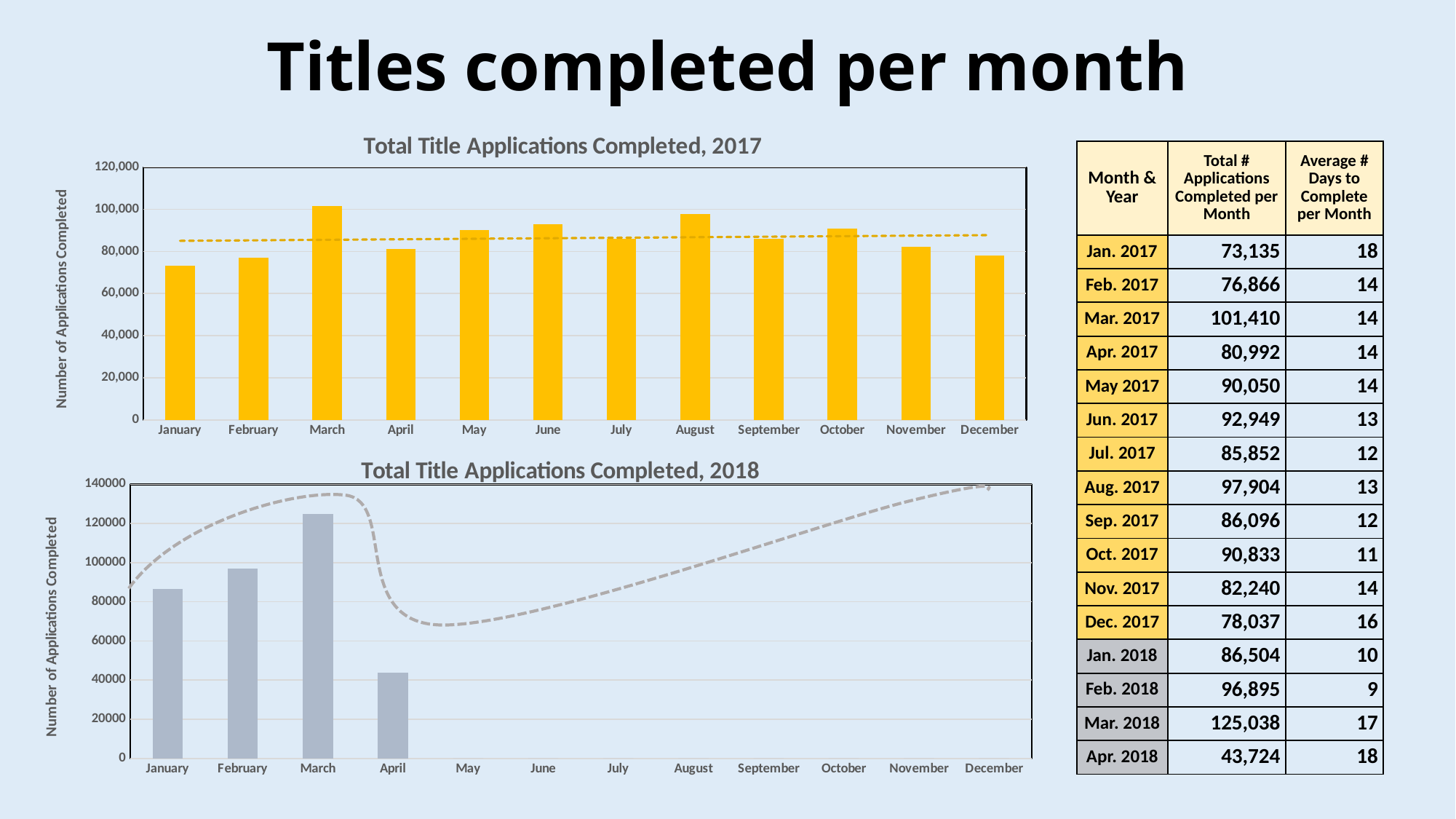
What kind of chart is "Total Title Applications Completed, 2017"? bar chart In the "Total Title Applications Completed, 2017" chart, is the value for January greater or less than 80,000? less In the "Total Title Applications Completed, 2017" chart, which month has the lowest bar? January What is the y-axis title of the "Total Title Applications Completed, 2018" chart? Number of Applications Completed According to the table on the slide, how many title applications were completed in Mar. 2017? 101,410 In the "Total Title Applications Completed, 2017" chart, which is larger, the value for June or the value for July? June In the "Total Title Applications Completed, 2017" chart, which month has the highest bar? March In the "Total Title Applications Completed, 2018" chart, is the value for April greater or less than 60000? less In the "Total Title Applications Completed, 2017" chart, how many months are shown on the x axis? 12 Using the values in the table, what is the difference between the applications completed in Mar. 2018 and Apr. 2018? 81,314 In the "Total Title Applications Completed, 2018" chart, which month has the highest bar? March In the "Total Title Applications Completed, 2018" chart, how many months have a bar plotted? 4